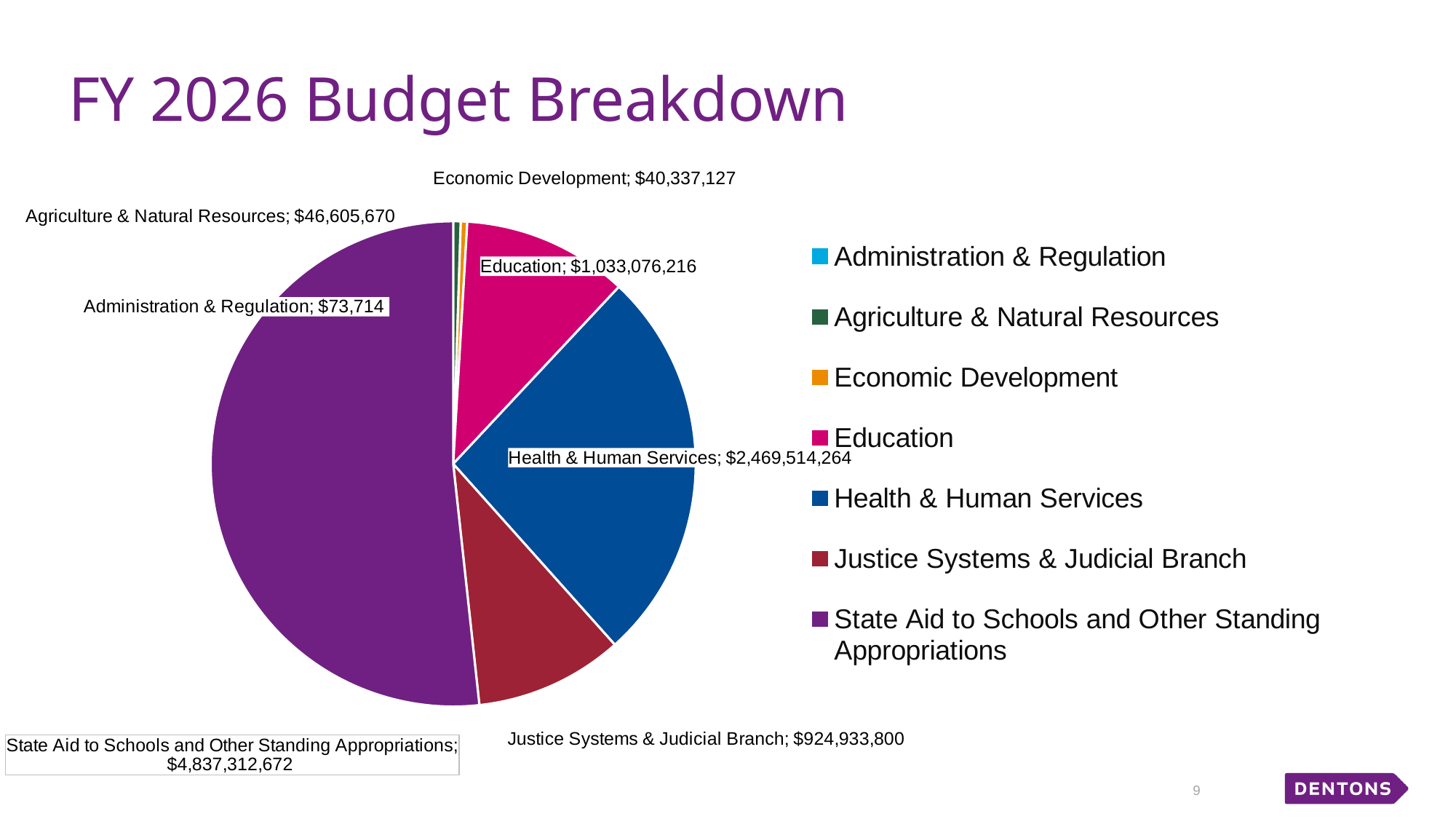
What is the difference between Agriculture & Natural Resources and Economic Development? $6,268,543 What is the title of the slide? FY 2026 Budget Breakdown How many categories does the pie chart show? 7 What kind of chart is shown on the slide? Pie chart Which category has the smallest value? Administration & Regulation What is the difference between Health & Human Services and Education? $1,436,438,048 What is the value for Health & Human Services? $2,469,514,264 Which category has the largest value? State Aid to Schools and Other Standing Appropriations What is the value for Education? $1,033,076,216 What is the value for Administration & Regulation? $73,714 Which is larger, Education or Justice Systems & Judicial Branch? Education What is the value for Justice Systems & Judicial Branch? $924,933,800